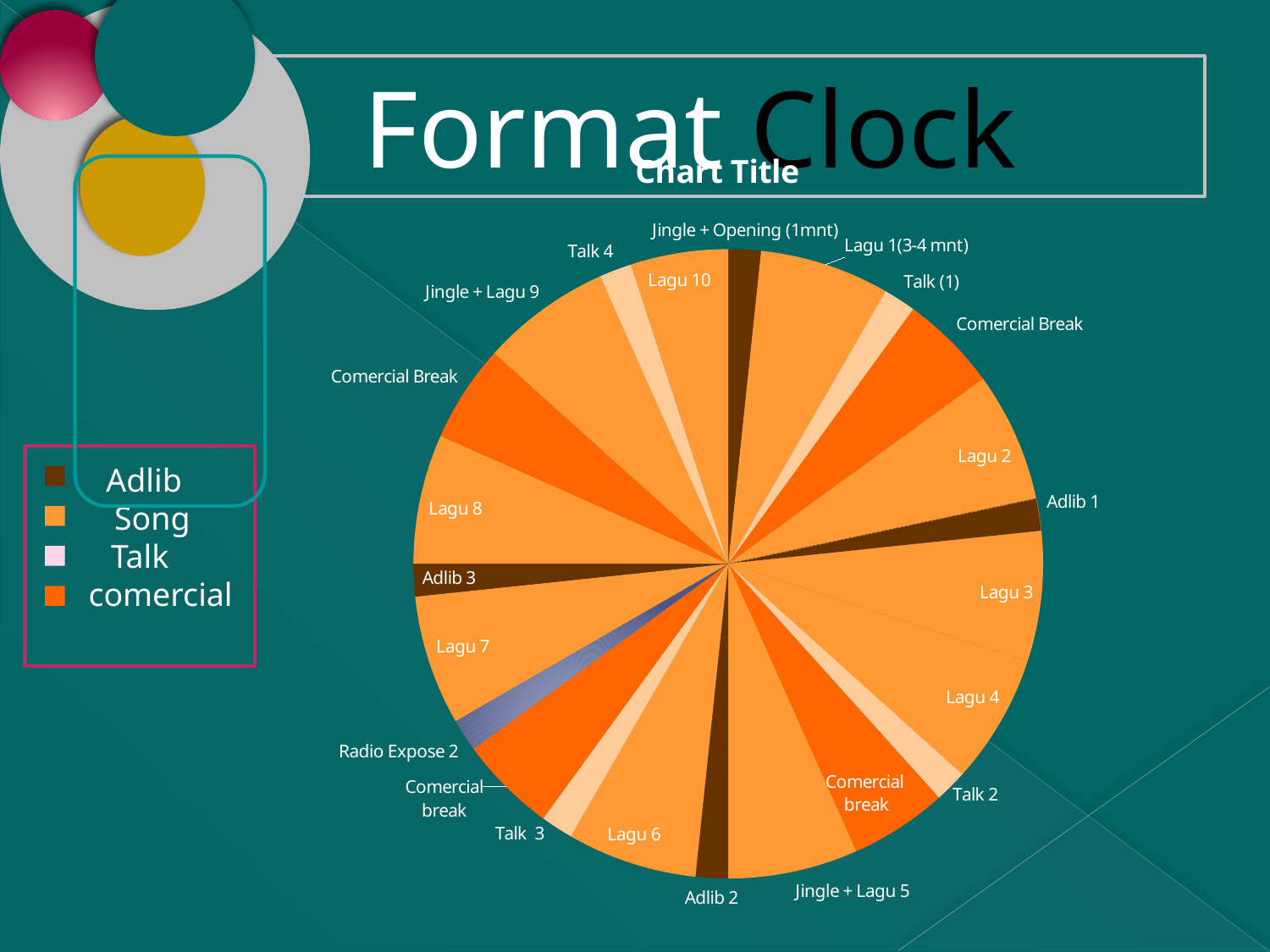
Which slice is larger, Lagu 8 or Talk 4? Lagu 8 How many entries does the legend on the left of the slide list? 4 Which slice is larger, Lagu 3 or Adlib 1? Lagu 3 Which slice is larger, Lagu 6 or Adlib 2? Lagu 6 What kind of chart is shown on the slide? pie chart What is the title printed above the pie chart? Chart Title According to the legend, which category is shown in dark brown? Adlib